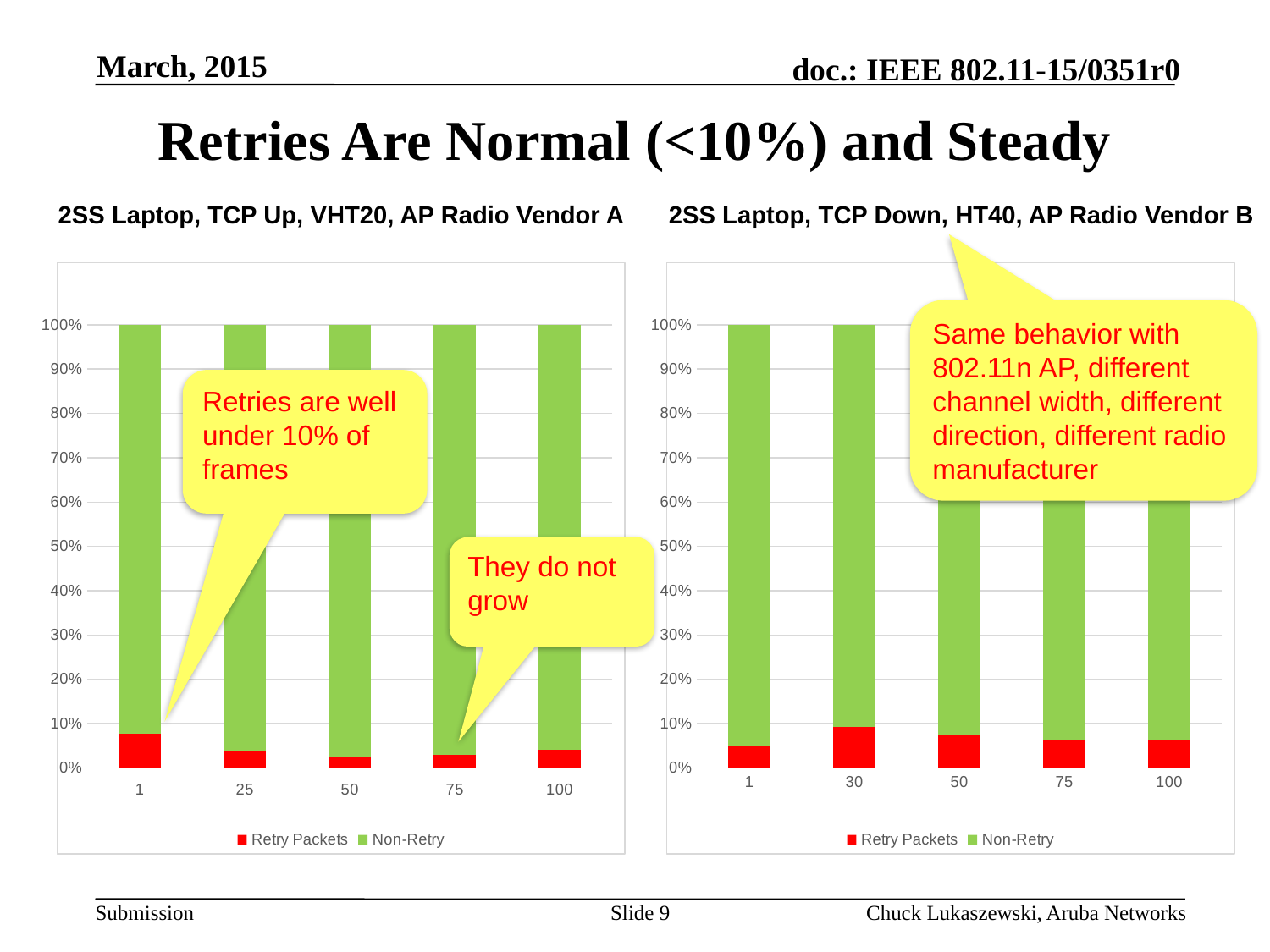
In the right chart ("2SS Laptop, TCP Down, HT40, AP Radio Vendor B"), is the Retry Packets share larger for category 1 or category 30? 30 How many series does the legend of the right chart ("2SS Laptop, TCP Down, HT40, AP Radio Vendor B") list? 2 How many categories are shown on the x axis of the left chart ("2SS Laptop, TCP Up, VHT20, AP Radio Vendor A")? 5 In the right chart ("2SS Laptop, TCP Down, HT40, AP Radio Vendor B"), what is the total height of the stacked bar for category 75? 100% In the left chart ("2SS Laptop, TCP Up, VHT20, AP Radio Vendor A"), is the Non-Retry value for category 50 greater or less than 90%? greater In the left chart ("2SS Laptop, TCP Up, VHT20, AP Radio Vendor A"), which category has the highest Retry Packets share? 1 In the left chart ("2SS Laptop, TCP Up, VHT20, AP Radio Vendor A"), is the Retry Packets share larger for category 1 or category 50? 1 In the right chart ("2SS Laptop, TCP Down, HT40, AP Radio Vendor B"), which category has the highest Retry Packets share? 30 In the left chart ("2SS Laptop, TCP Up, VHT20, AP Radio Vendor A"), is the Retry Packets value for category 1 greater or less than 10%? less What colour represents the Retry Packets series in both charts? Red What kind of chart is the left chart titled "2SS Laptop, TCP Up, VHT20, AP Radio Vendor A"? Stacked bar chart